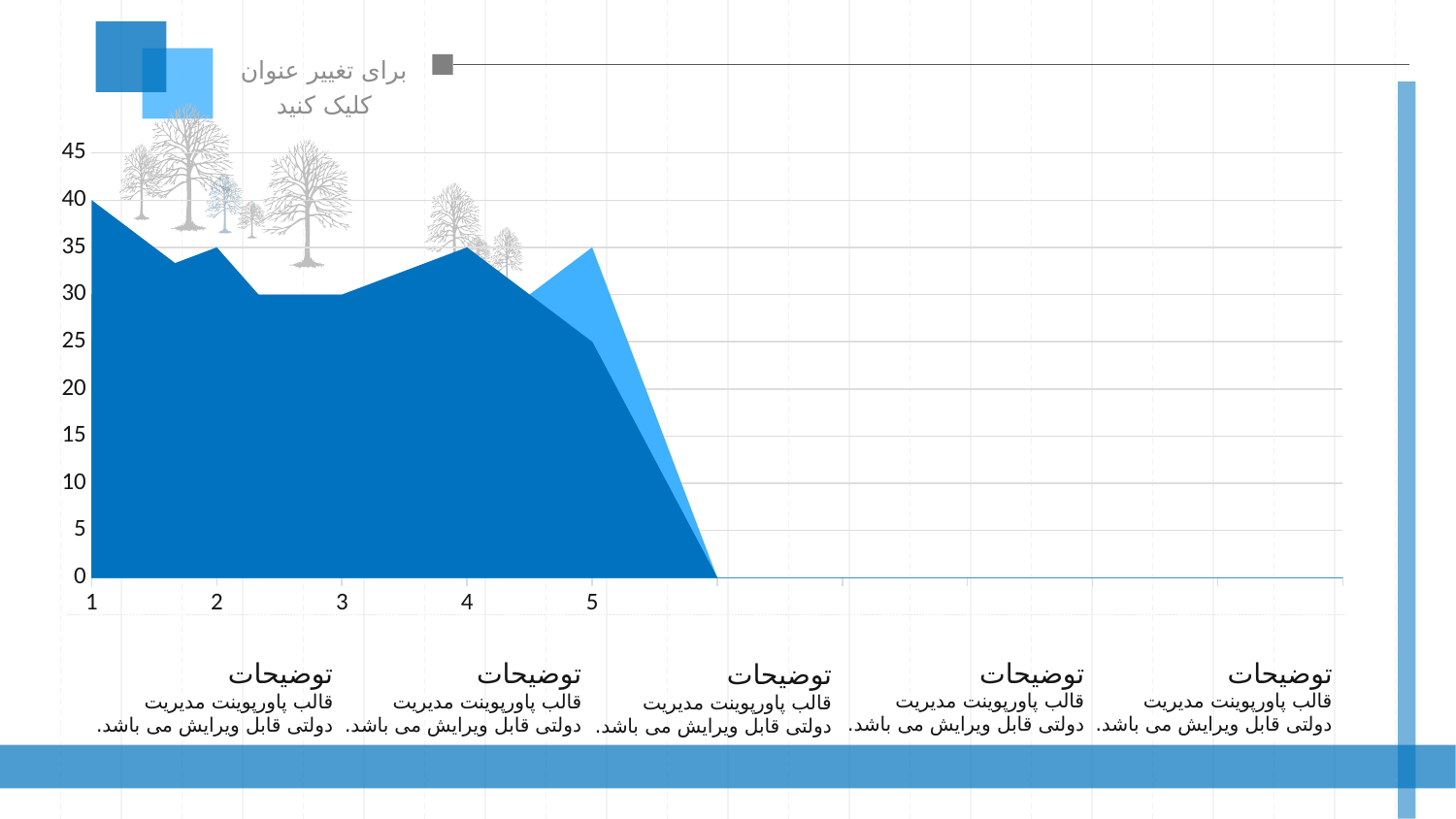
What kind of chart is shown on the slide? area chart At which x-axis label does the dark blue series reach its highest value? 1 What is the value of the dark blue series at x = 1? 40 What is the highest value shown on the y axis? 45 Do the values of the dark blue series rise or fall from x = 1 to x = 3? fall Is the value of the dark blue series at x = 5 greater or less than 30? less What is the value of the dark blue series at x = 3? 30 Is the value of the light blue series at x = 5 greater or less than 30? greater Which is larger for the dark blue series: the value at x = 1 or the value at x = 5? x = 1 Among the labeled x-axis points 1 to 5, at which one is the dark blue series lowest? 5 Is the value of the dark blue series at x = 2 greater or less than 30? greater How many numbered labels appear on the x axis? 5